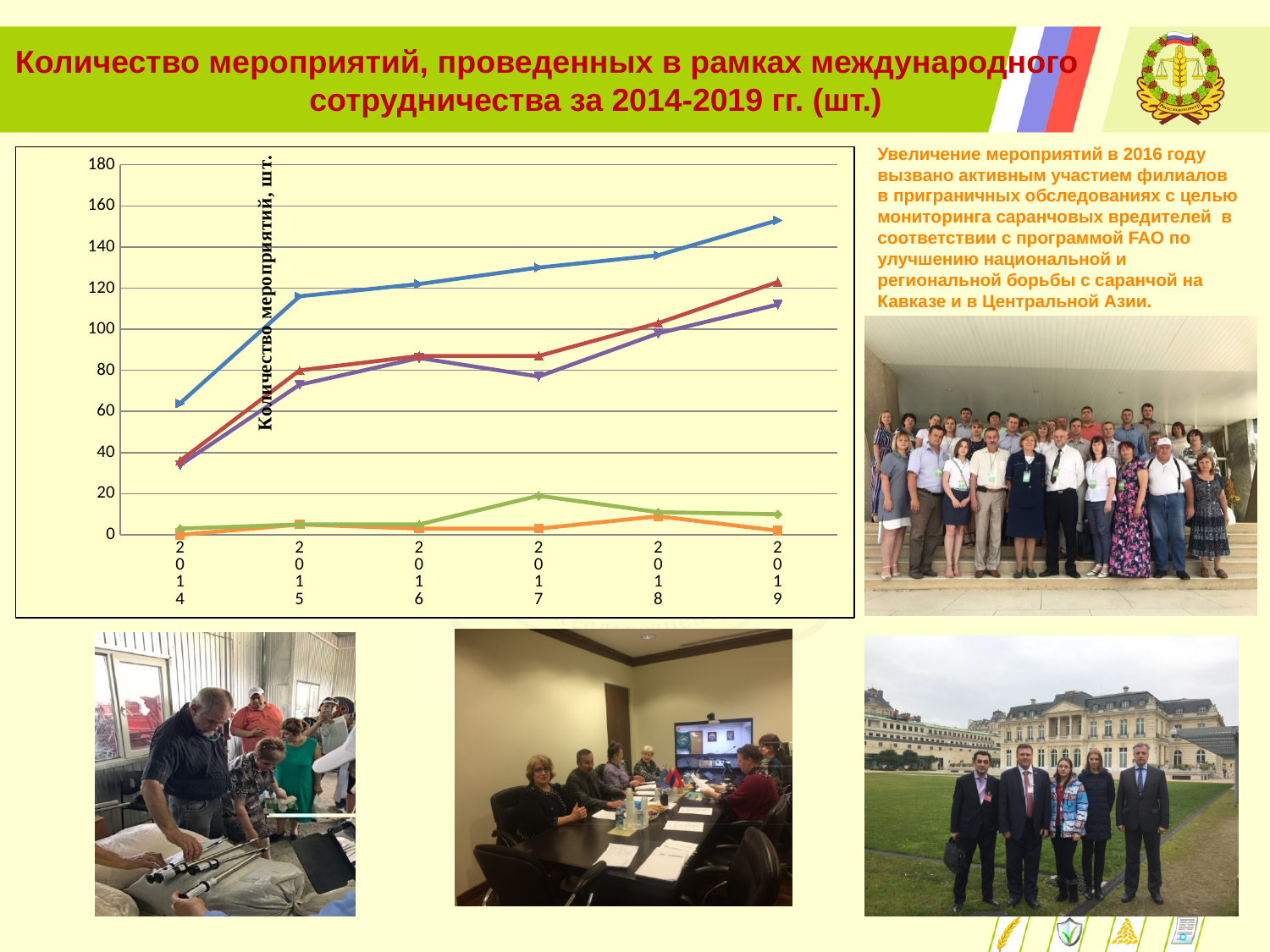
Is the value of the red line in 2019 greater or less than 100? greater In which year does the green line reach its highest value? 2017 What kind of chart is shown on the slide? line chart What is the title of the vertical axis of the chart? Количество мероприятий, шт. In which year does the blue line have its lowest value? 2014 Is the value of the blue line in 2014 greater or less than 80? less In 2019, which line has the larger value, the blue line or the red line? blue line In which year does the blue line reach its highest value? 2019 How many lines are plotted on the chart? 5 Does the blue line rise or fall from 2014 to 2019? rise How many years are plotted along the x axis of the chart? 6 Is the value of the blue line in 2019 greater or less than 140? greater